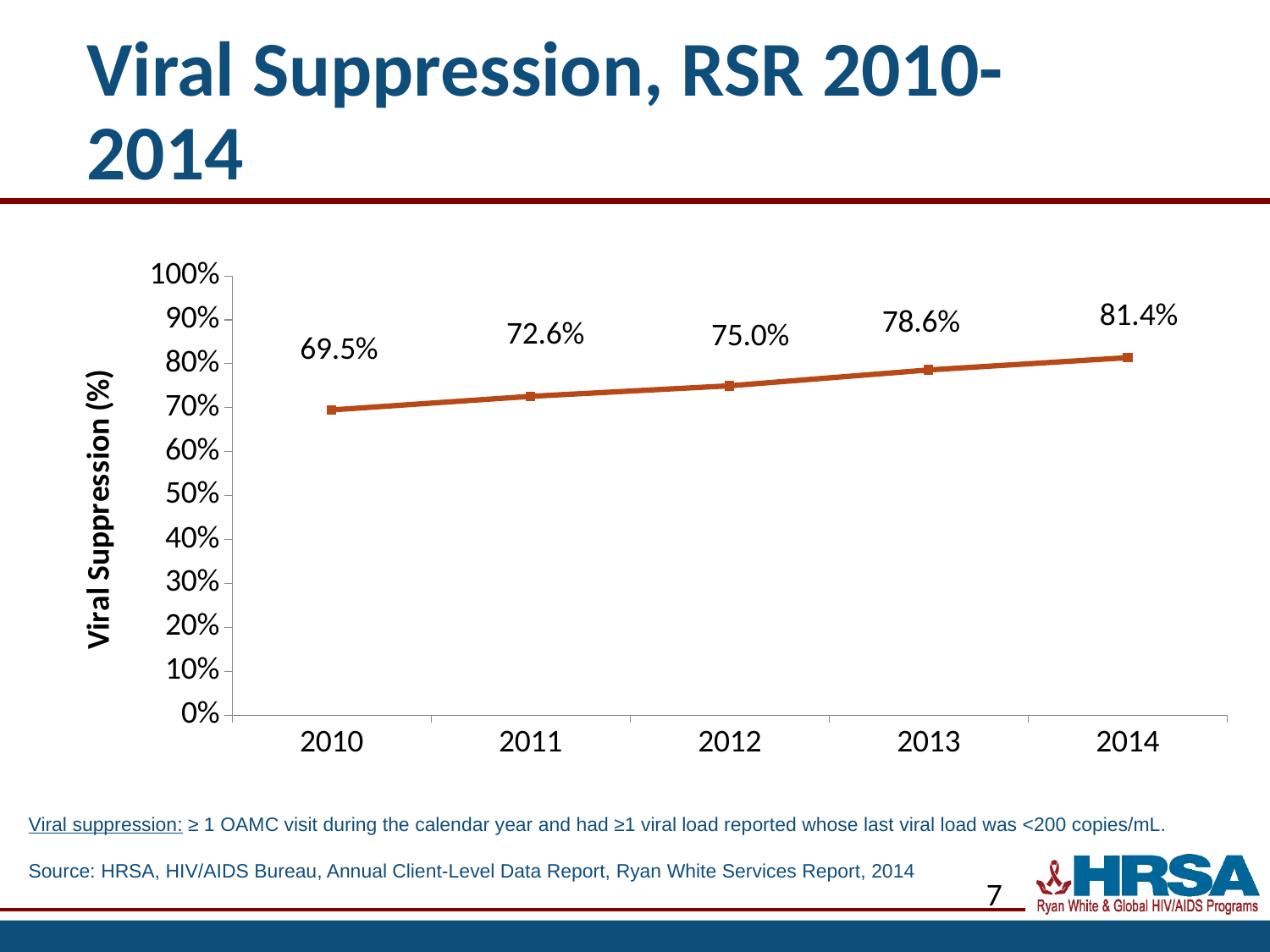
Does viral suppression rise or fall from 2010 to 2014? rise What was the viral suppression percentage in 2010? 69.5% What is the difference in viral suppression between 2014 and 2010? 11.9% Which year had a higher viral suppression percentage, 2011 or 2013? 2013 Which year had the highest viral suppression percentage? 2014 What kind of chart is shown on the slide? line chart What is the difference in viral suppression between 2013 and 2012? 3.6% Which year had the lowest viral suppression percentage? 2010 What was the viral suppression percentage in 2014? 81.4% How many years are plotted on the chart? 5 What was the viral suppression percentage in 2012? 75.0% Is the viral suppression value for 2013 greater or less than 70%? greater